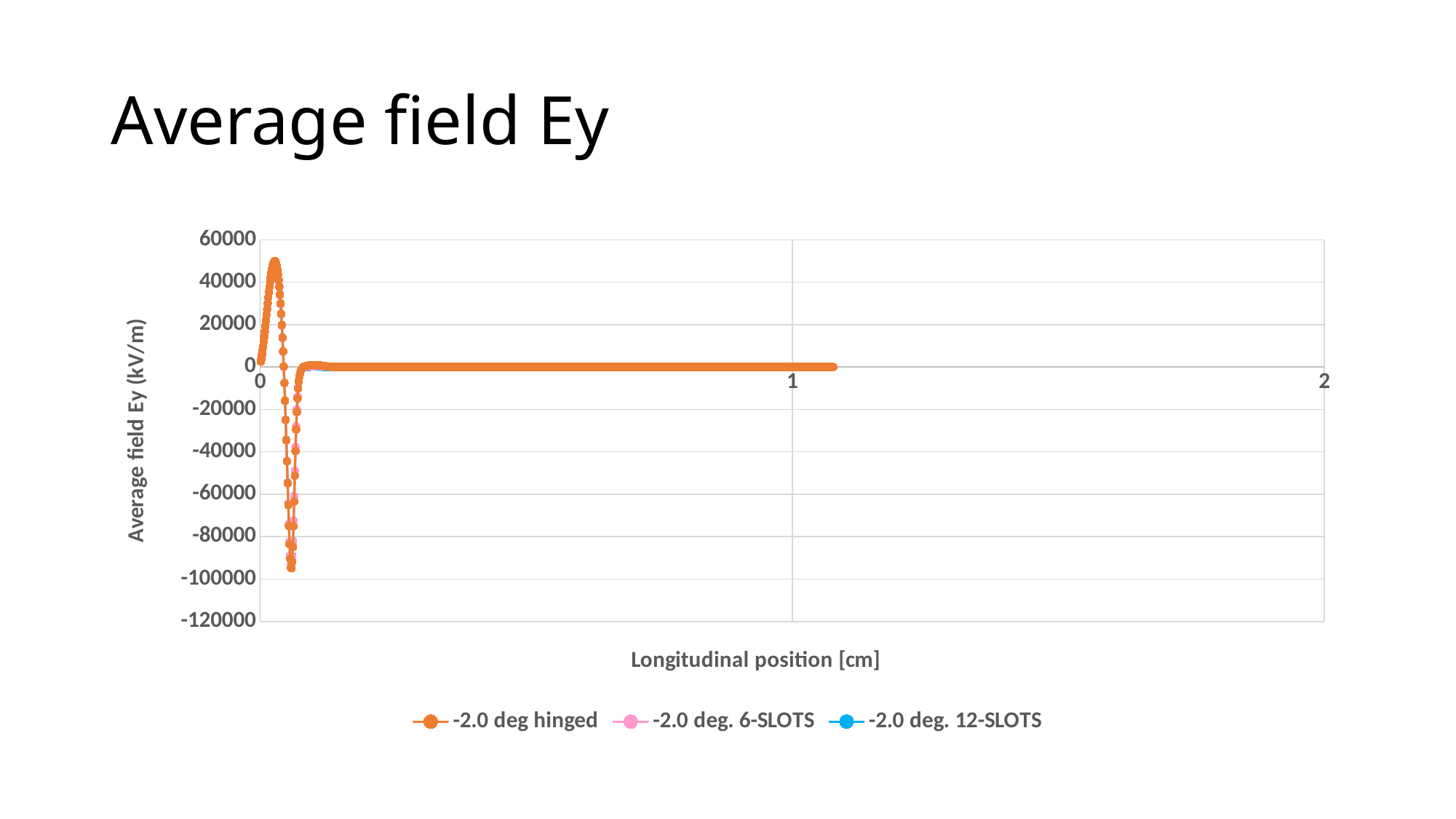
What kind of chart is shown on the slide? line chart What is the title of the chart? Average field Ey Is the peak value of the -2.0 deg hinged series greater or less than 60000? less How many series does the legend list? 3 Is the lowest value of the -2.0 deg hinged series greater or less than -80000? less What is the highest tick value shown on the vertical axis? 60000 Does the -2.0 deg hinged series rise or fall immediately after its positive peak near the start of the x axis? fall Which is larger in magnitude for the -2.0 deg hinged series: the positive peak or the negative dip? the negative dip Is the lowest value of the -2.0 deg hinged series greater or less than -120000? greater What is the label of the vertical axis? Average field Ey (kV/m)